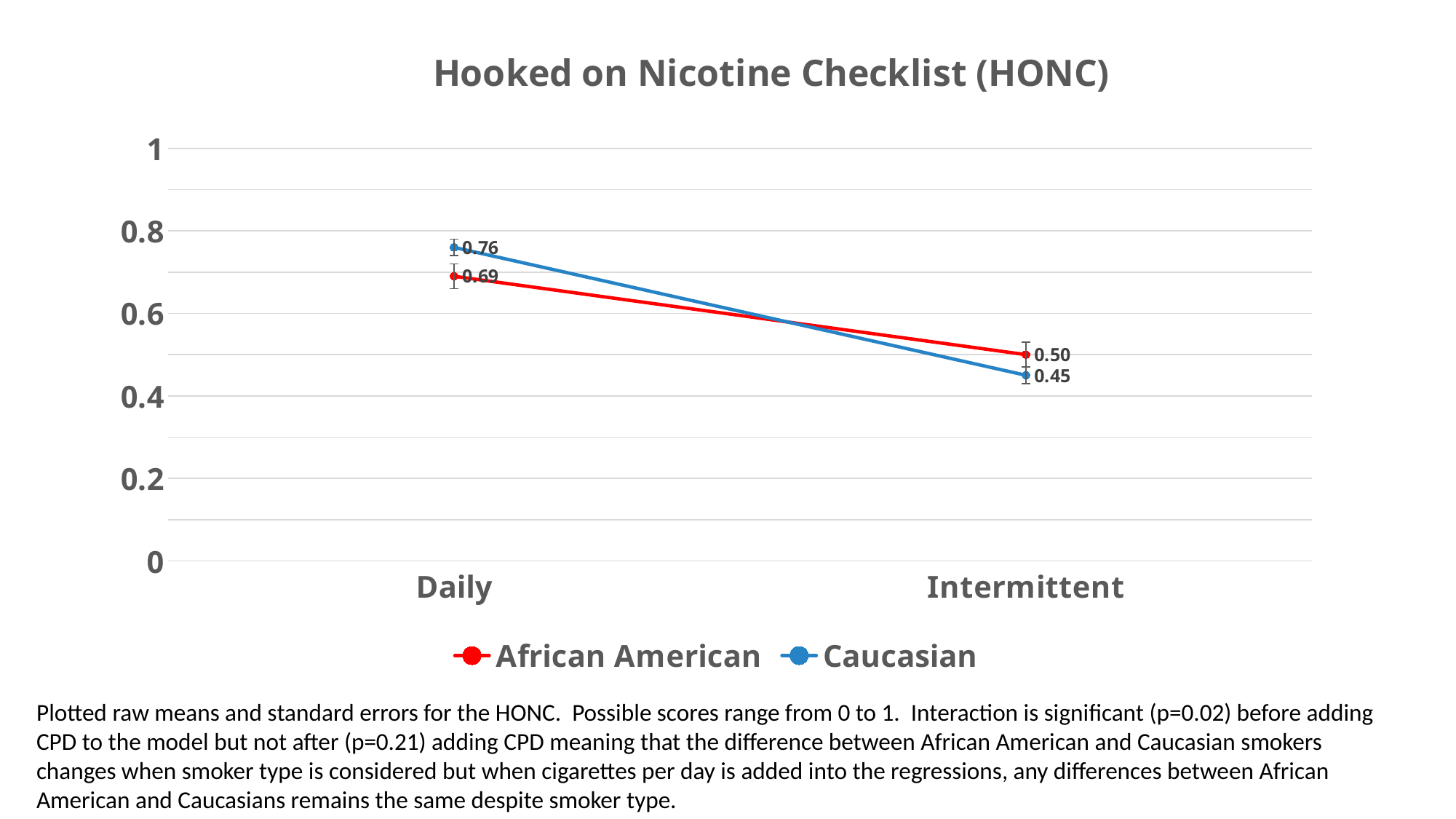
Which series has the higher value in the Intermittent category? African American What is the difference between the Daily and Intermittent values for the Caucasian series? 0.31 What is the HONC value for African American smokers in the Intermittent category? 0.50 What is the difference between the Caucasian and African American values in the Daily category? 0.07 How many categories are shown on the x axis? 2 What is the HONC value for African American smokers in the Daily category? 0.69 Which series has the higher value in the Daily category? Caucasian What kind of chart is this? Line chart What is the HONC value for Caucasian smokers in the Intermittent category? 0.45 Do the values for the African American series rise or fall from Daily to Intermittent? Fall How many series does the legend list? 2 What is the HONC value for Caucasian smokers in the Daily category? 0.76